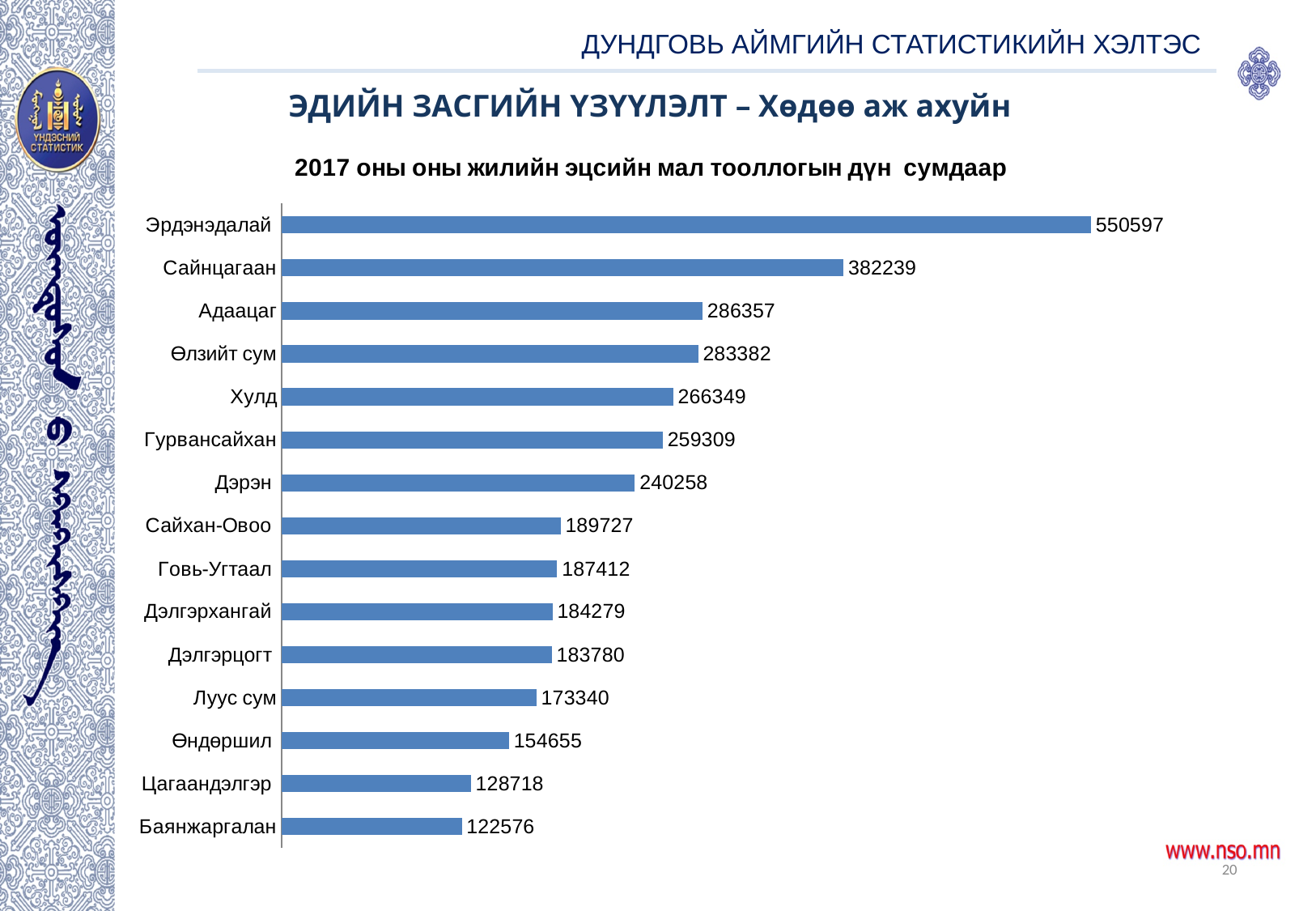
What is the value for Өндөршил? 154655 What is the difference between the values for Өндөршил and Цагаандэлгэр? 25937 What is the value for Дэрэн? 240258 What is the title of the chart? 2017 оны оны жилийн эцсийн мал тооллогын дүн сумдаар What is the value for Луус сум? 173340 What kind of chart is shown on the slide? Bar chart What is the value for Эрдэнэдалай? 550597 Which category has the highest value? Эрдэнэдалай How many categories are shown in the chart? 15 What is the difference between the values for Эрдэнэдалай and Сайнцагаан? 168358 Which category has the lowest value? Баянжаргалан Which has a larger value, Хулд or Дэрэн? Хулд